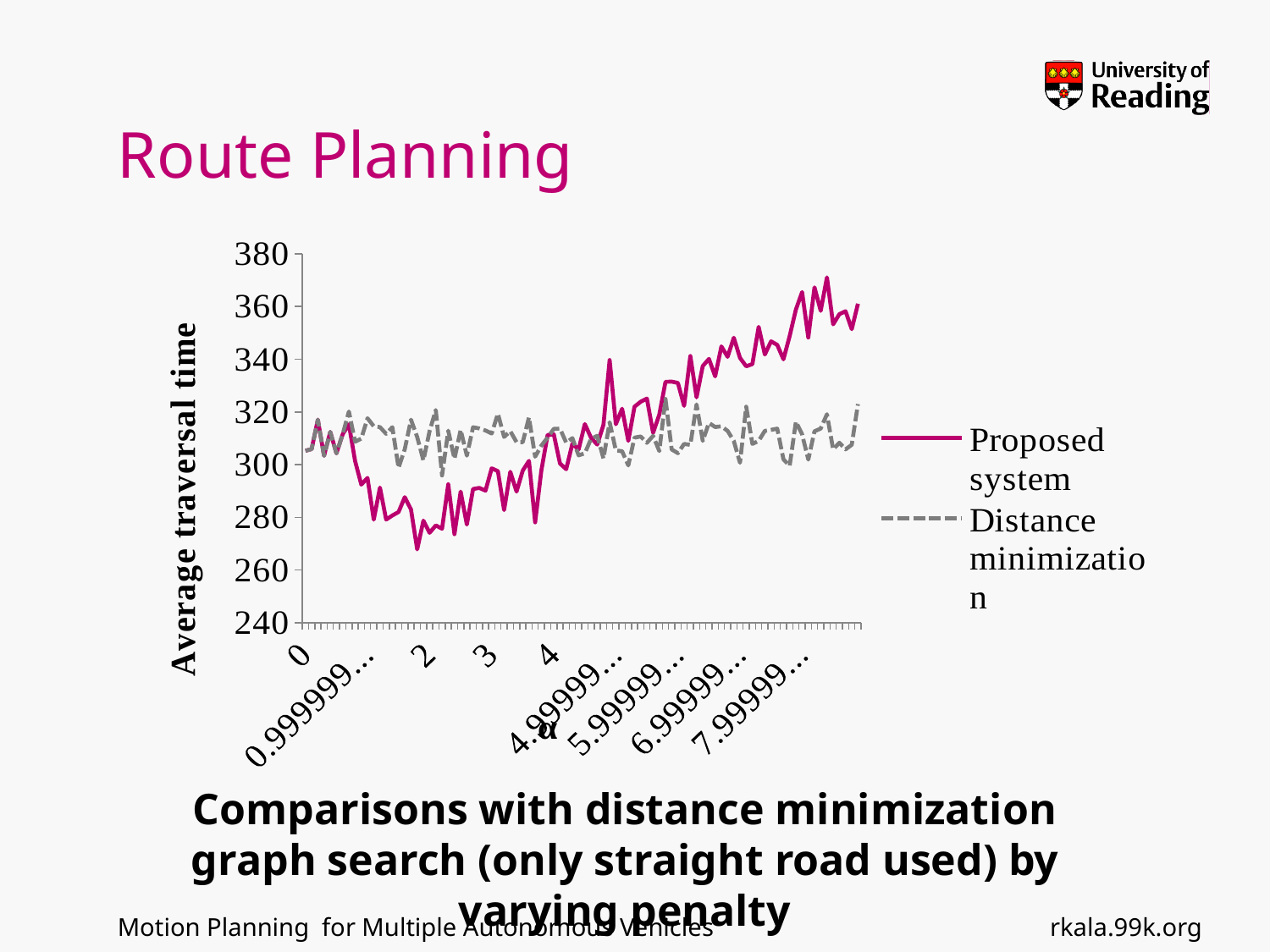
Is the value of the Proposed system line at α = 2 greater or less than 300? less Which series reaches the highest value shown on the chart? Proposed system Which series reaches the lowest value shown on the chart? Proposed system At α = 7, which series has the higher average traversal time, Proposed system or Distance minimization? Proposed system Is the value of the Proposed system line at the right end of the chart (around α = 8) greater or less than 340? greater At α = 2, which series has the higher average traversal time, Proposed system or Distance minimization? Distance minimization What is the title of the vertical axis? Average traversal time What kind of chart is shown on the slide? line chart How many series does the legend list? 2 What are the two series named in the legend? Proposed system; Distance minimization Is the Distance minimization line ever above 340 anywhere on the chart? no From α = 4 to the right end of the chart, does the Proposed system line generally rise or fall? rise